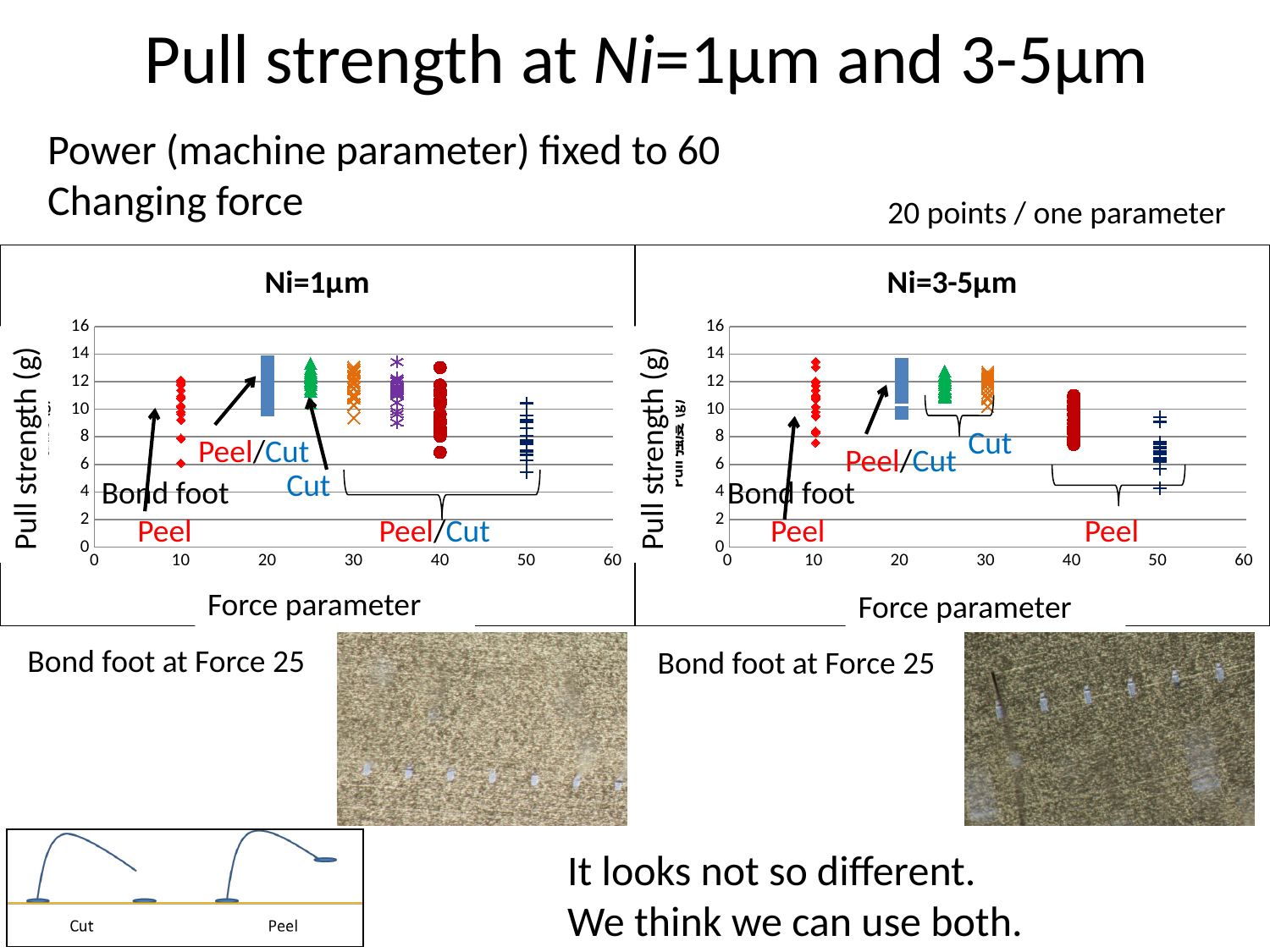
What is the highest tick value shown on the y-axis of the "Ni=3-5μm" chart? 16 In the "Ni=1μm" chart, do the pull strength values rise or fall between force parameter 40 and force parameter 50? fall What is the x-axis label of the "Ni=1μm" chart? Force parameter In the "Ni=1μm" chart, how many distinct force parameter values have data points plotted? 7 In the "Ni=3-5μm" chart, are the pull strength values at force parameter 50 greater or less than 10? less In the "Ni=1μm" chart, are the pull strength values at force parameter 25 greater or less than 8? greater In the "Ni=3-5μm" chart, are the pull strength values at force parameter 40 greater or less than 12? less In the "Ni=3-5μm" chart, which force parameter has the lowest pull strength values? 50 What kind of chart is the "Ni=1μm" chart? scatter chart What is the title of the chart on the right side of the slide? Ni=3-5μm In the "Ni=3-5μm" chart, how many distinct force parameter values have data points plotted? 6